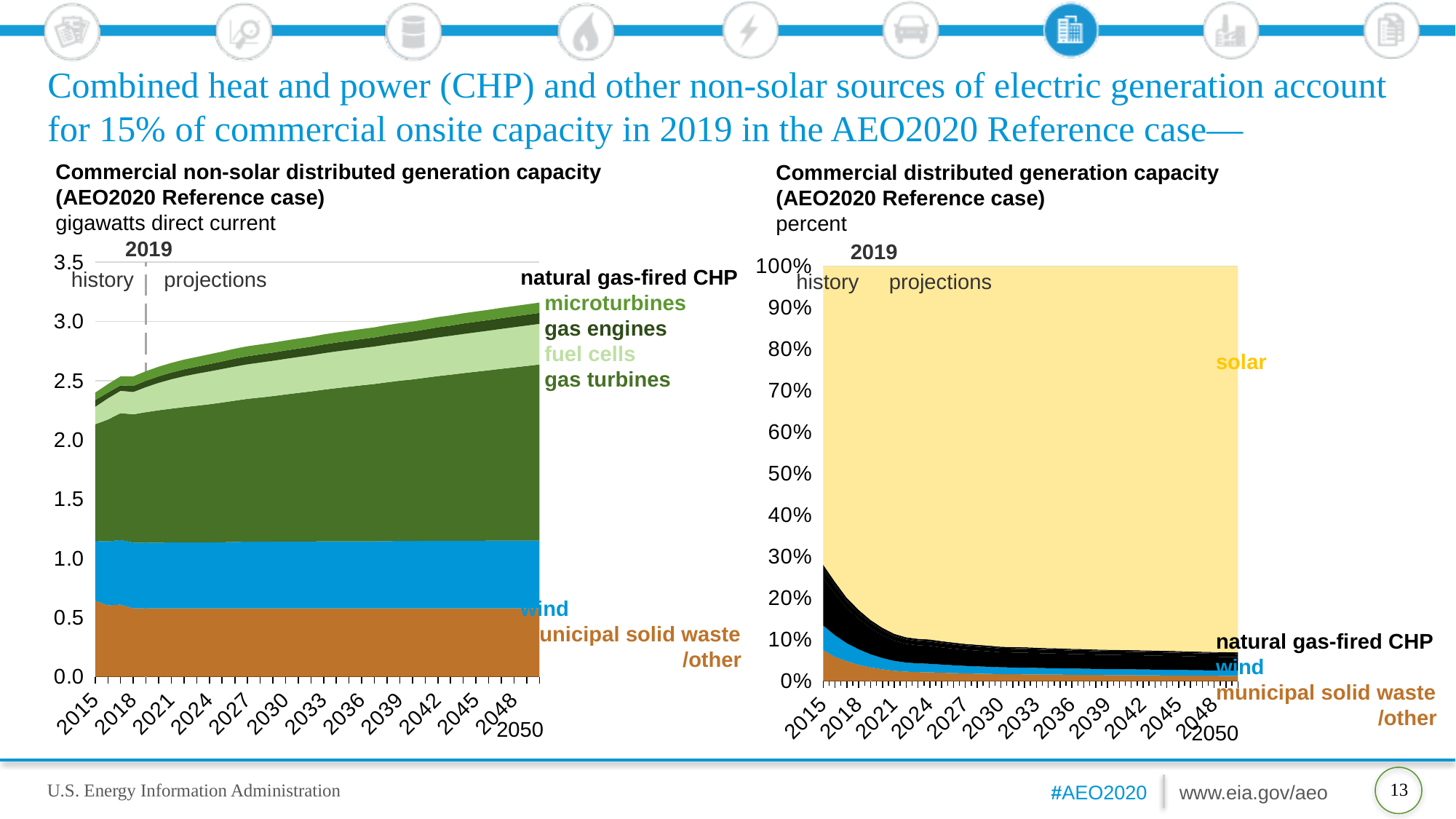
In the right chart, 'Commercial distributed generation capacity', does the share of solar rise or fall from 2015 to 2050? rise In the left chart, 'Commercial non-solar distributed generation capacity', is the total capacity in 2015 greater or less than 3.0? less In what unit is the left chart, 'Commercial non-solar distributed generation capacity', measured? gigawatts direct current In what unit is the right chart, 'Commercial distributed generation capacity', measured? percent In the left chart, 'Commercial non-solar distributed generation capacity', does total capacity rise or fall from 2015 to 2050? rise What kind of chart is the left chart, 'Commercial non-solar distributed generation capacity'? stacked area chart In the left chart, 'Commercial non-solar distributed generation capacity', is the total capacity in 2050 greater or less than 3.0? greater In the right chart, 'Commercial distributed generation capacity', which source has the largest share in 2050? solar In the left chart, 'Commercial non-solar distributed generation capacity', which is larger in 2050: gas turbines or wind? gas turbines In the right chart, 'Commercial distributed generation capacity', is the share of solar in 2015 greater or less than 50%? greater How many sub-categories of natural gas-fired CHP are labelled on the left chart, 'Commercial non-solar distributed generation capacity'? 4